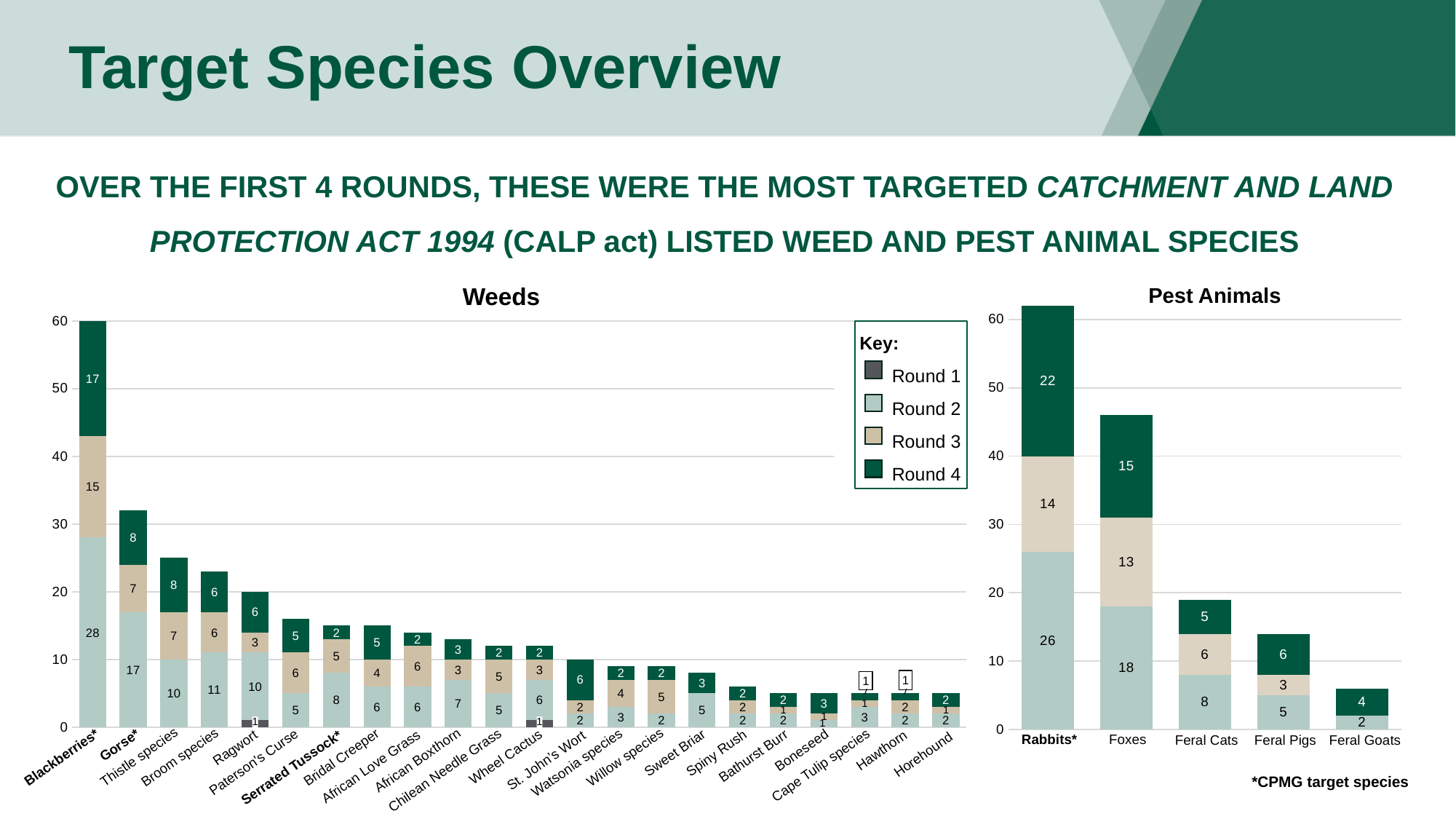
In the Pest Animals chart, what is the Round 3 value for Rabbits*? 14 In the Pest Animals chart, what is the Round 2 value for Foxes? 18 In the Pest Animals chart, which category has the tallest stacked bar? Rabbits* In the Pest Animals chart, what is the total of the stacked bar for Feral Cats? 19 In the Pest Animals chart, is the Round 4 value larger for Rabbits* or for Foxes? Rabbits* In the Weeds chart, what is the difference between the Round 2 values for Blackberries* and Gorse*? 11 How many series does the key list for the charts? 4 In the Weeds chart, what is the total of the stacked bar for Gorse*? 32 In the Pest Animals chart, which category has the shortest stacked bar? Feral Goats In the Weeds chart, what is the Round 4 value for Blackberries*? 17 What kind of chart is the Weeds chart? Stacked bar chart How many categories are shown in the Pest Animals chart? 5